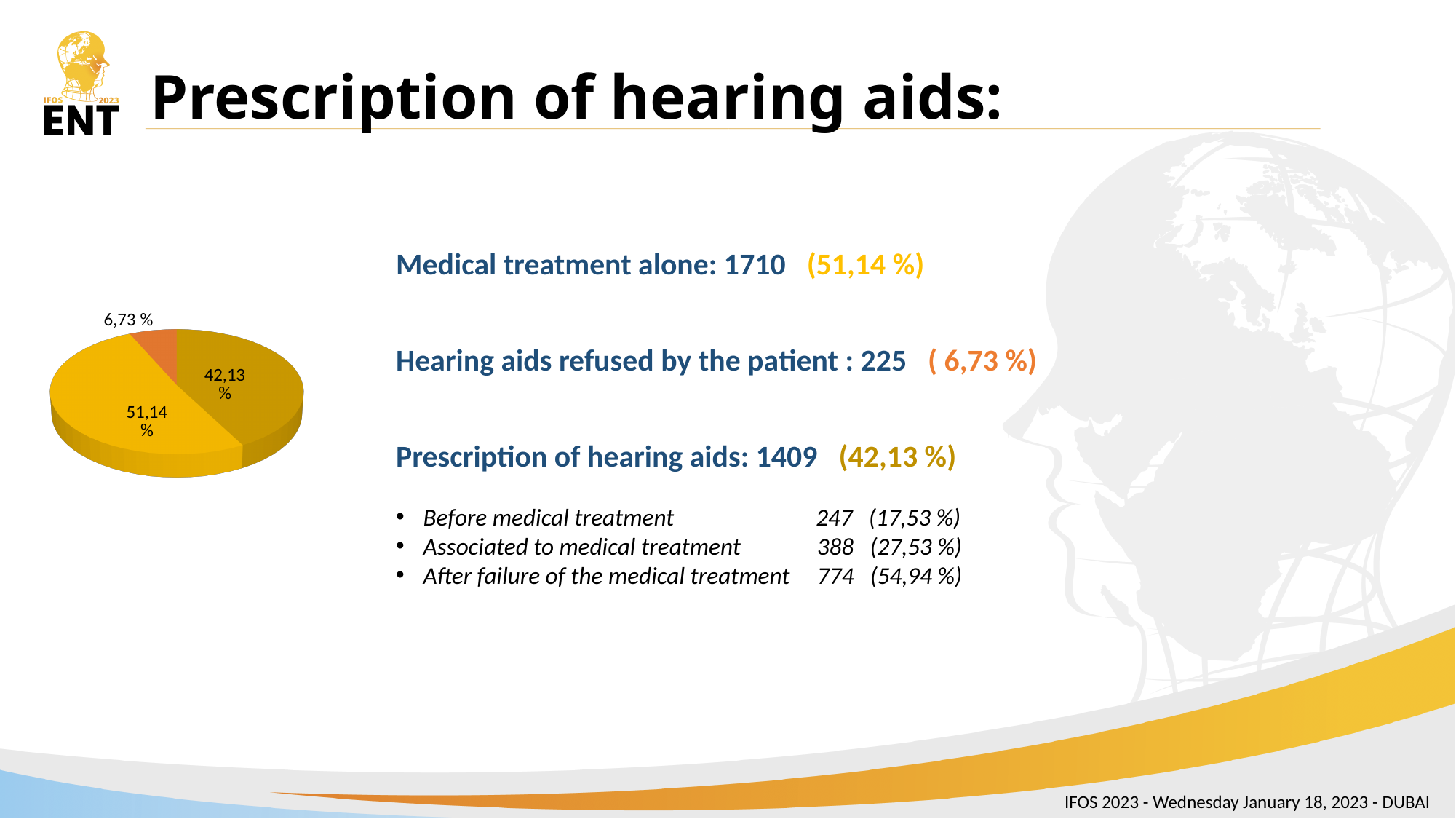
What percentage is shown for the light yellow slice of the pie chart? 51,14 % How many slices does the pie chart have? 3 What percentage is shown for the orange slice of the pie chart? 6,73 % What percentage is shown for the dark gold slice of the pie chart? 42,13 % What is the largest share shown in the pie chart? 51,14 % Which is larger in the pie chart: the slice labelled 42,13 % or the slice labelled 51,14 %? 51,14 % What is the difference in percentage points between the 51,14 % slice and the 42,13 % slice of the pie chart? 9,01 What kind of chart is shown on the slide? Pie chart What is the difference in percentage points between the 42,13 % slice and the 6,73 % slice of the pie chart? 35,40 Is the share of the orange slice in the pie chart greater or less than 10 %? less Does the pie chart display a legend? No What is the smallest share shown in the pie chart? 6,73 %